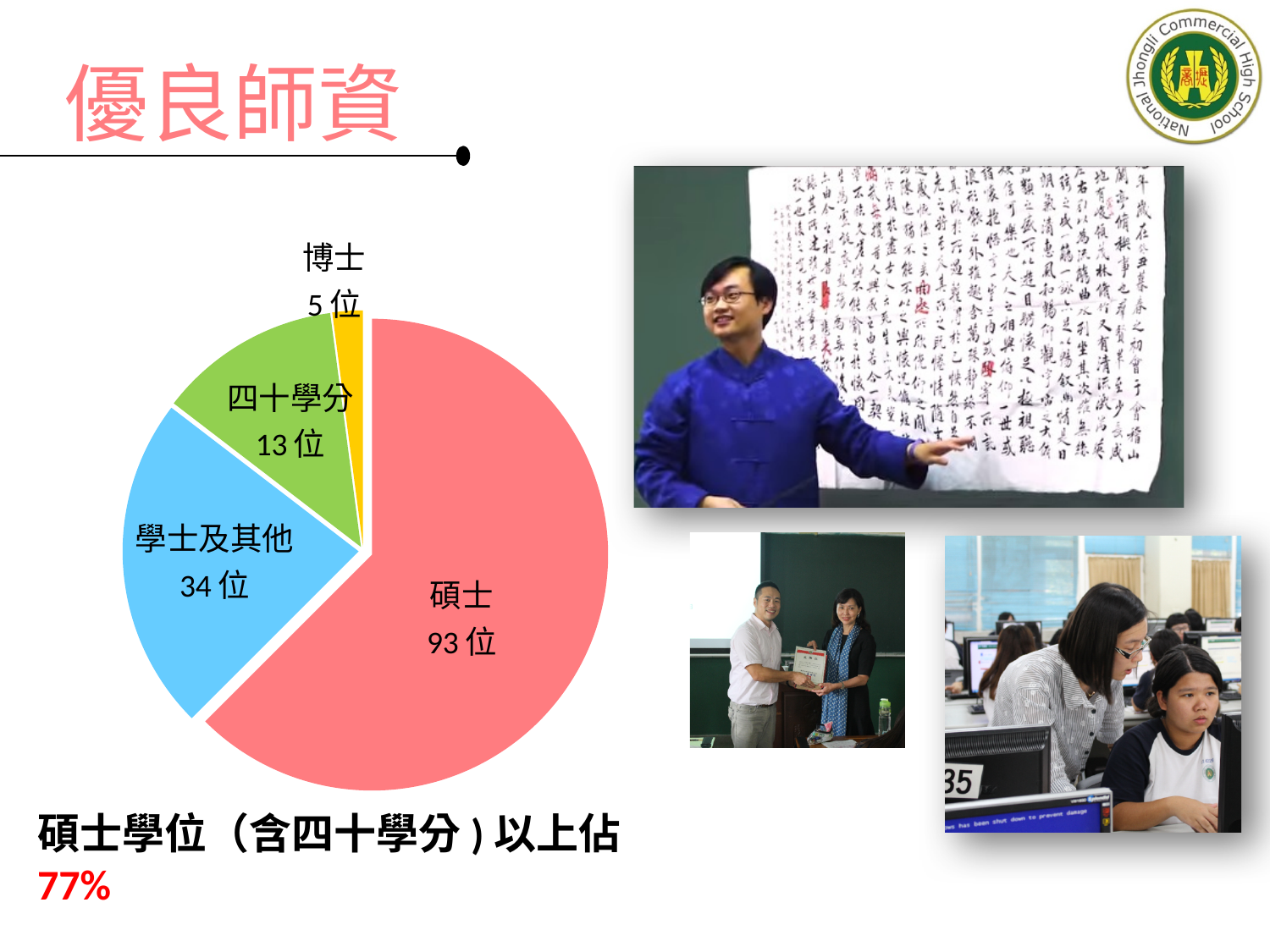
How many slices does the pie chart have? 4 What is the total of all four slices in the pie chart? 145 位 What is the difference between the values for 碩士 and 學士及其他? 59 位 What is the value for 博士 in the pie chart? 5 位 What kind of chart is shown on the slide? pie chart What is the value for 學士及其他 in the pie chart? 34 位 Which category has the smallest slice in the pie chart? 博士 What is the value for 碩士 in the pie chart? 93 位 What is the value for 四十學分 in the pie chart? 13 位 Which category has the largest slice in the pie chart? 碩士 According to the text below the chart, what percentage of teachers hold a master's degree or above (including 四十學分)? 77% Which is larger, the value for 四十學分 or the value for 博士? 四十學分